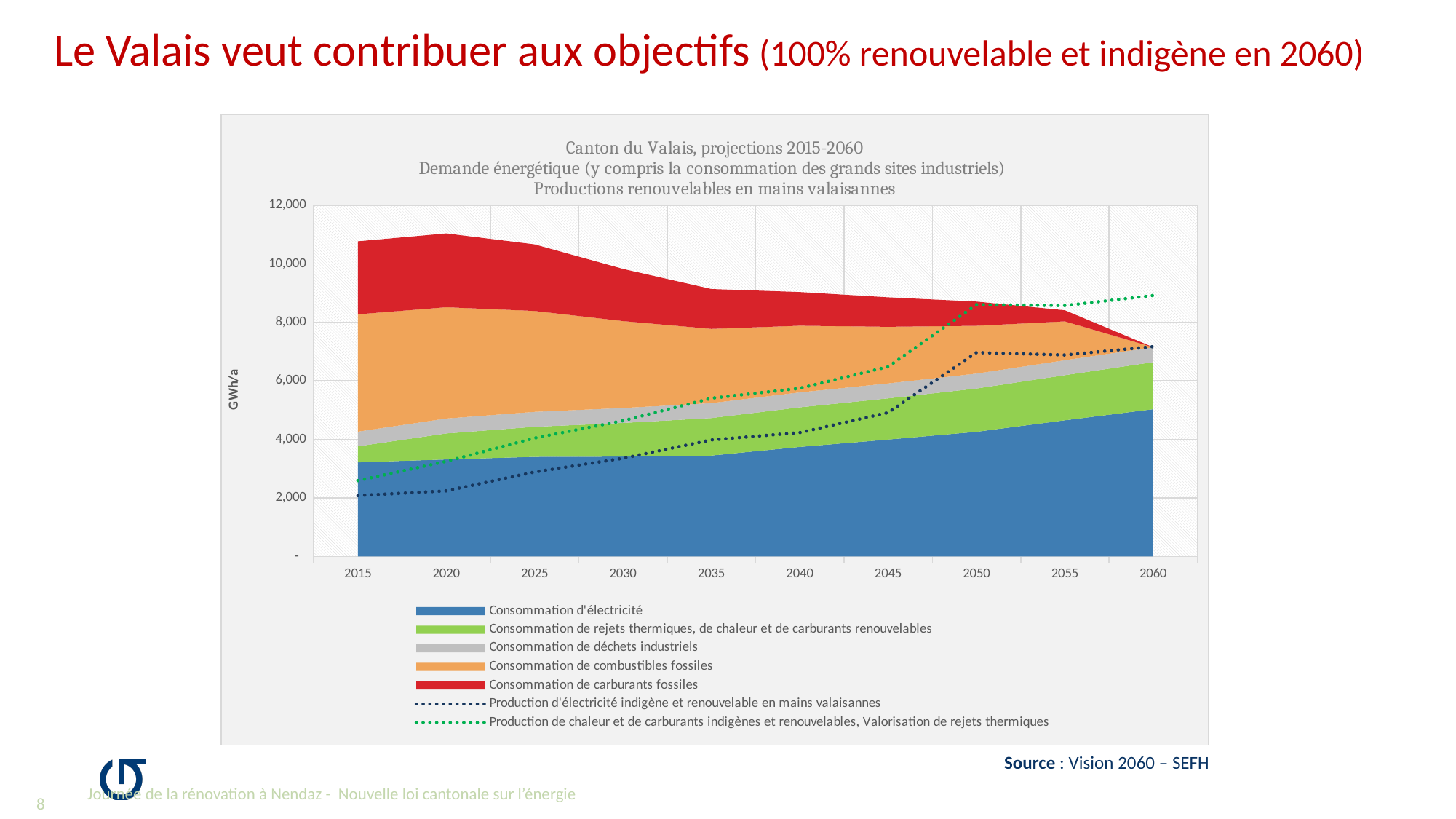
Does the total stacked energy demand rise or fall from 2020 to 2060? Falls Is the value of the green dotted line (Production de chaleur et de carburants indigènes et renouvelables) in 2060 greater or less than 8,000 GWh/a? greater What is the first line of the chart title? Canton du Valais, projections 2015-2060 Is the total stacked demand in 2015 greater or less than 10,000 GWh/a? greater What kind of chart is shown on the slide? Stacked area chart with dotted line series How many series does the legend list? 7 In which year is the total stacked energy demand lowest? 2060 In 2060, which dotted line is higher: the green one (Production de chaleur et de carburants) or the navy one (Production d'électricité indigène)? The green one (Production de chaleur et de carburants indigènes et renouvelables) Does the 'Consommation d'électricité' area rise or fall from 2015 to 2060? Rises How many years are labelled on the x axis? 10 Is the total stacked demand in 2060 greater or less than 8,000 GWh/a? less What is the unit shown on the y axis? GWh/a